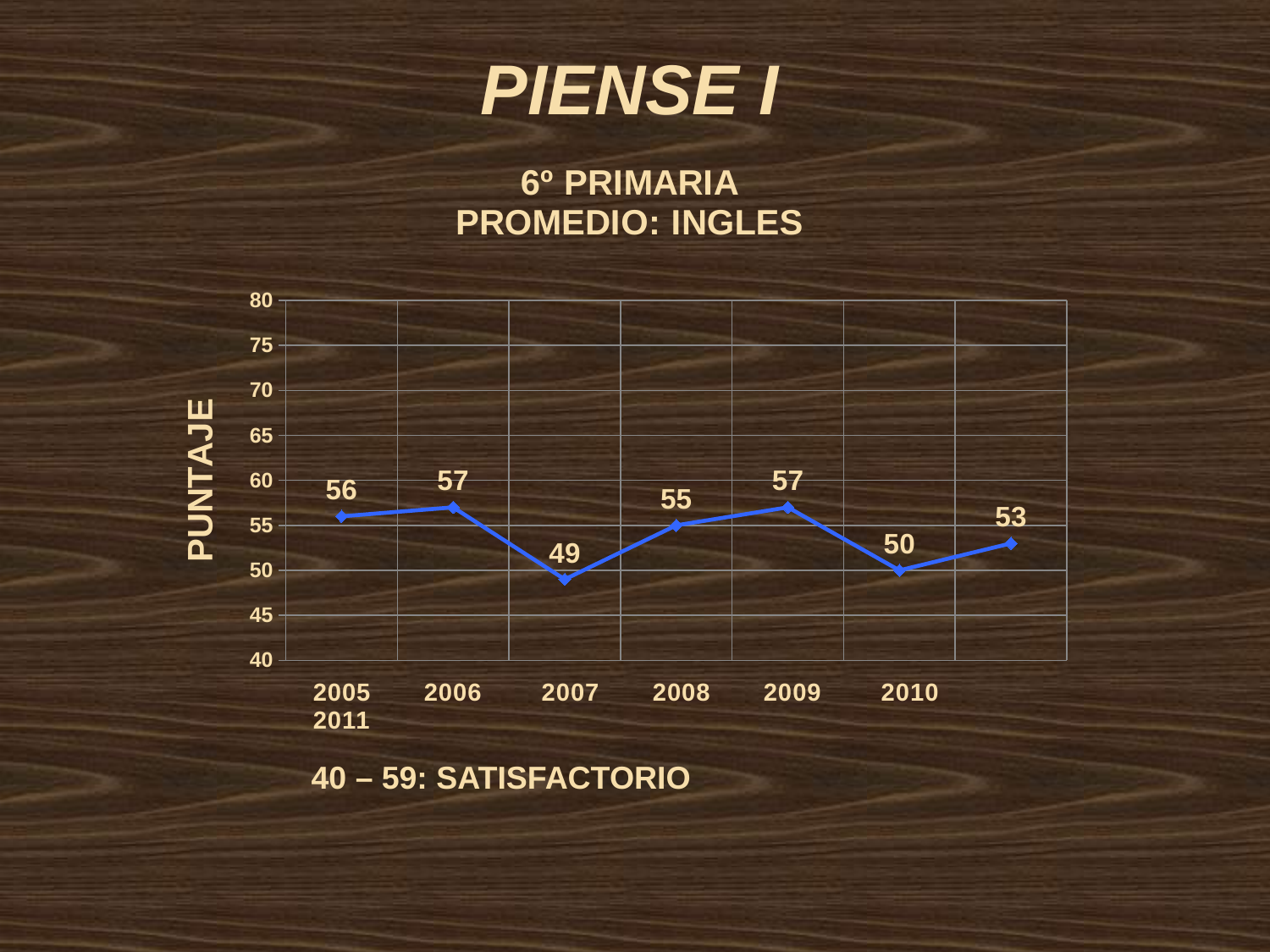
What is the value for 2010? 50 What is the difference between the values for 2006 and 2007? 8 Does the value rise or fall from 2009 to 2010? fall What is the value for 2007? 49 What is the label on the vertical axis? PUNTAJE Which is larger, the value for 2008 or the value for 2010? 2008 What is the value for 2005? 56 What is the value for 2008? 55 What type of chart is shown on the slide? line chart Which year has the lowest value? 2007 What is the highest value plotted on the chart? 57 How many data points are plotted on the chart? 7